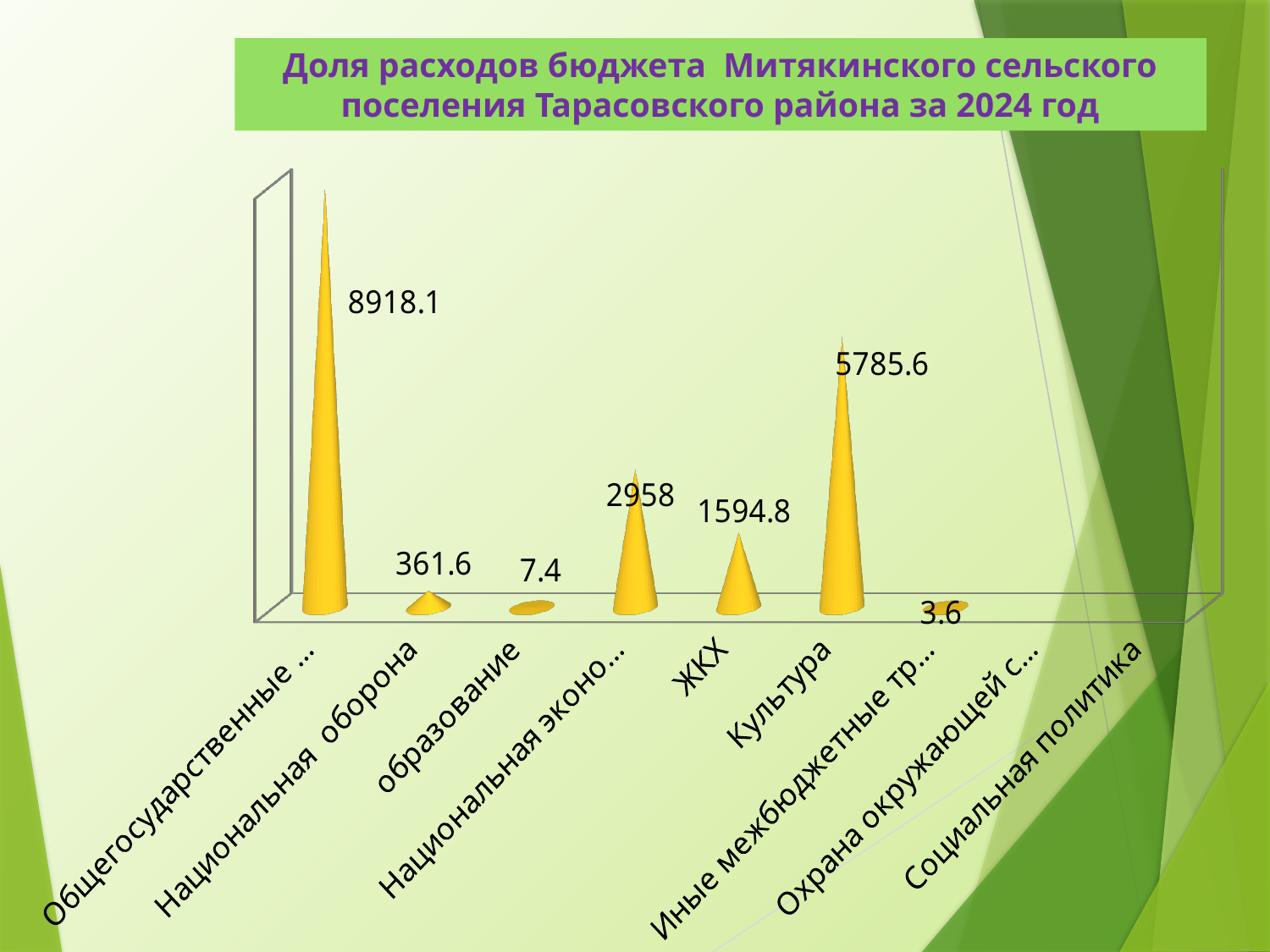
What is the difference between the values for Национальная оборона and образование? 354.2 What year does the chart title refer to? 2024 What is the value shown for the first category, Общегосударственные? 8918.1 What kind of chart is shown on the slide? bar chart What is the value for ЖКХ? 1594.8 What is the value for образование? 7.4 Which category has the highest value? Общегосударственные What is the difference between the values for Культура and ЖКХ? 4190.8 What is the value for Культура? 5785.6 Which is larger, the value for Культура or the value for ЖКХ? Культура How many categories are shown on the x axis? 9 What is the value for Национальная оборона? 361.6